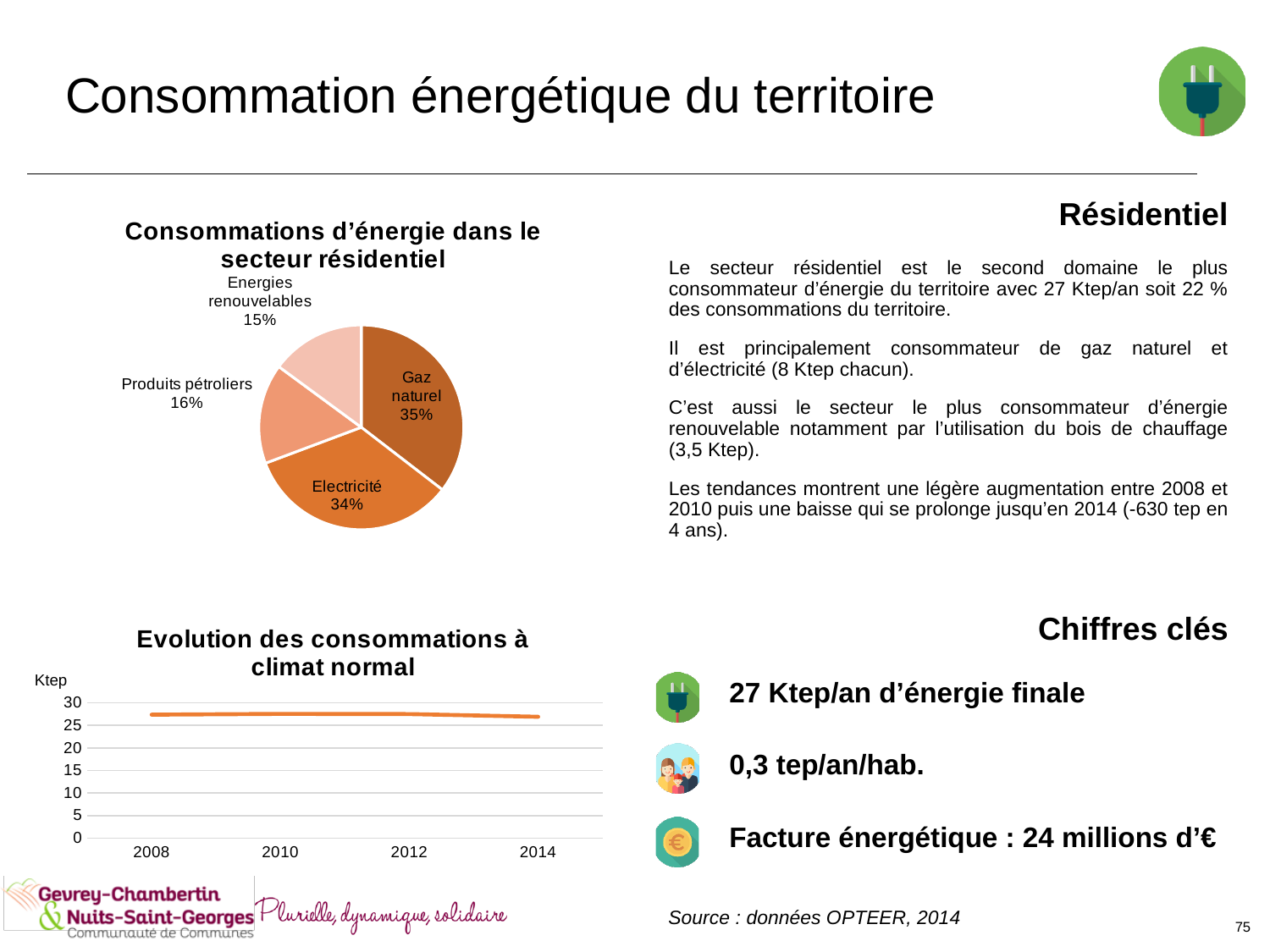
In the chart 'Evolution des consommations à climat normal', is the value for 2008 greater or less than 25? greater In the pie chart 'Consommations d'énergie dans le secteur résidentiel', which is larger: Produits pétroliers or Energies renouvelables? Produits pétroliers In the pie chart 'Consommations d'énergie dans le secteur résidentiel', what is the value shown for Electricité? 34% In the pie chart 'Consommations d'énergie dans le secteur résidentiel', which category has the smallest share? Energies renouvelables What kind of chart is 'Consommations d'énergie dans le secteur résidentiel'? Pie chart In the pie chart 'Consommations d'énergie dans le secteur résidentiel', which category has the largest share? Gaz naturel In the pie chart 'Consommations d'énergie dans le secteur résidentiel', what share does Gaz naturel represent? 35% In the pie chart 'Consommations d'énergie dans le secteur résidentiel', how many slices are there? 4 In the chart 'Evolution des consommations à climat normal', what unit is shown on the y axis? Ktep In the pie chart 'Consommations d'énergie dans le secteur résidentiel', what is the difference in percentage points between Gaz naturel and Energies renouvelables? 20 percentage points In the chart 'Evolution des consommations à climat normal', do the values rise or fall between 2010 and 2014? fall What kind of chart is 'Evolution des consommations à climat normal'? Line chart